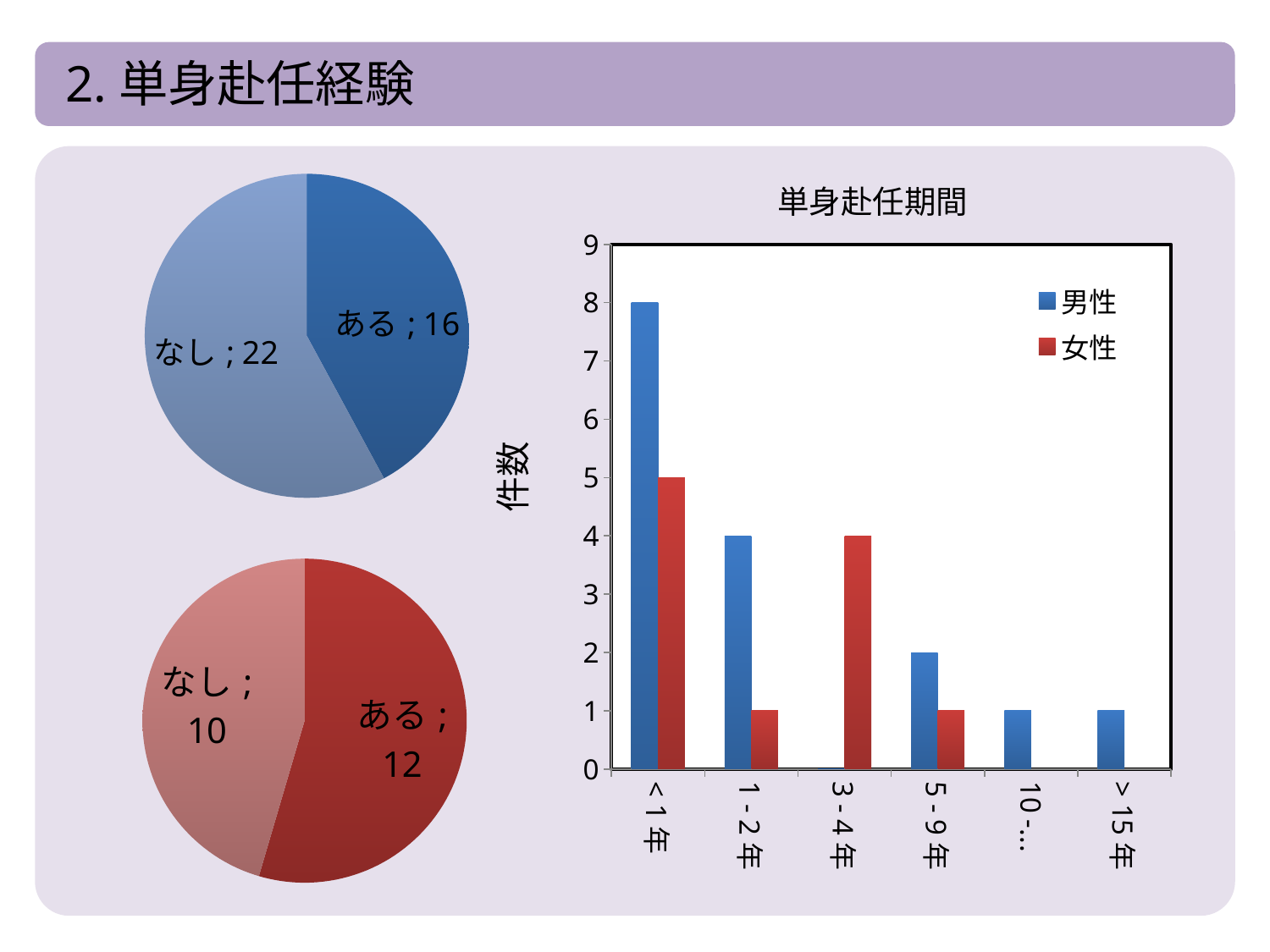
In the bar chart titled 単身赴任期間, which is larger in the 1 - 2 年 category, 男性 or 女性? 男性 In the top-left blue pie chart, what is the value for ある? 16 In the bar chart titled 単身赴任期間, which category has the highest value for 男性? < 1 年 In the bottom-left red pie chart, what is the value for ある? 12 In the top-left blue pie chart, what is the difference between なし and ある? 6 In the bar chart titled 単身赴任期間, how many series does the legend list? 2 In the bar chart titled 単身赴任期間, what is the value for 女性 in the 3 - 4 年 category? 4 In the bar chart titled 単身赴任期間, what is the value for 男性 in the < 1 年 category? 8 In the top-left blue pie chart, what is the value for なし? 22 In the bar chart titled 単身赴任期間, how many categories are shown on the x axis? 6 What kind of chart is the chart titled 単身赴任期間? bar chart In the bottom-left red pie chart, which slice is larger, ある or なし? ある